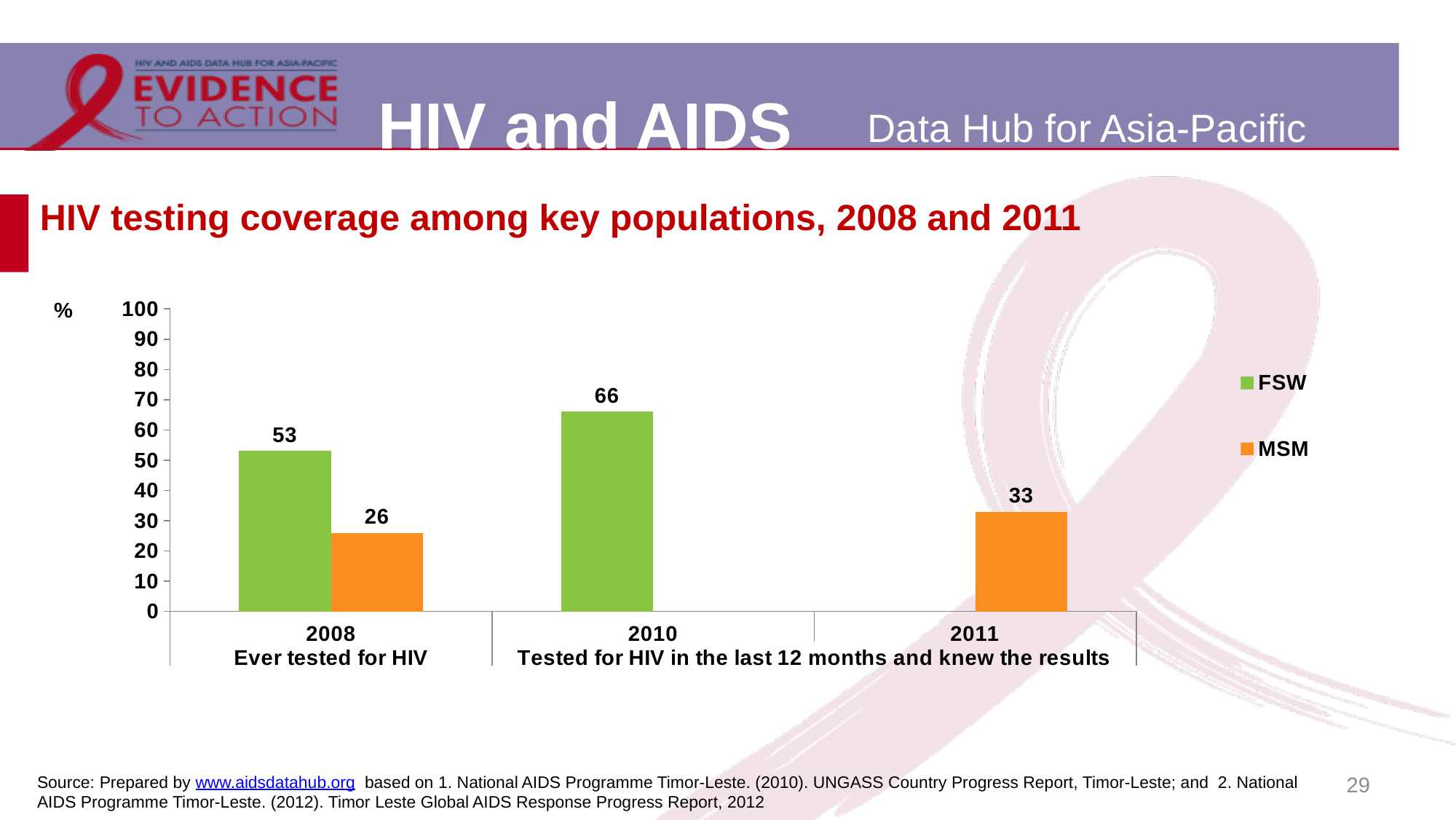
What is the difference between the FSW and MSM values in 2008? 27 What is the value for FSW in 2010 (Tested for HIV in the last 12 months and knew the results)? 66 What kind of chart is shown on the slide? Bar chart What is the difference between the FSW value in 2010 and the MSM value in 2011? 33 What is the value for MSM in 2008 (Ever tested for HIV)? 26 Which bar has the lowest value on the chart? MSM in 2008 What is the value for FSW in 2008 (Ever tested for HIV)? 53 What is the value for MSM in 2011 (Tested for HIV in the last 12 months and knew the results)? 33 Which bar has the highest value on the chart? FSW in 2010 How many series does the legend list? 2 Which is larger: the FSW value in 2008 or the MSM value in 2011? FSW in 2008 What colour represents MSM in the chart? Orange